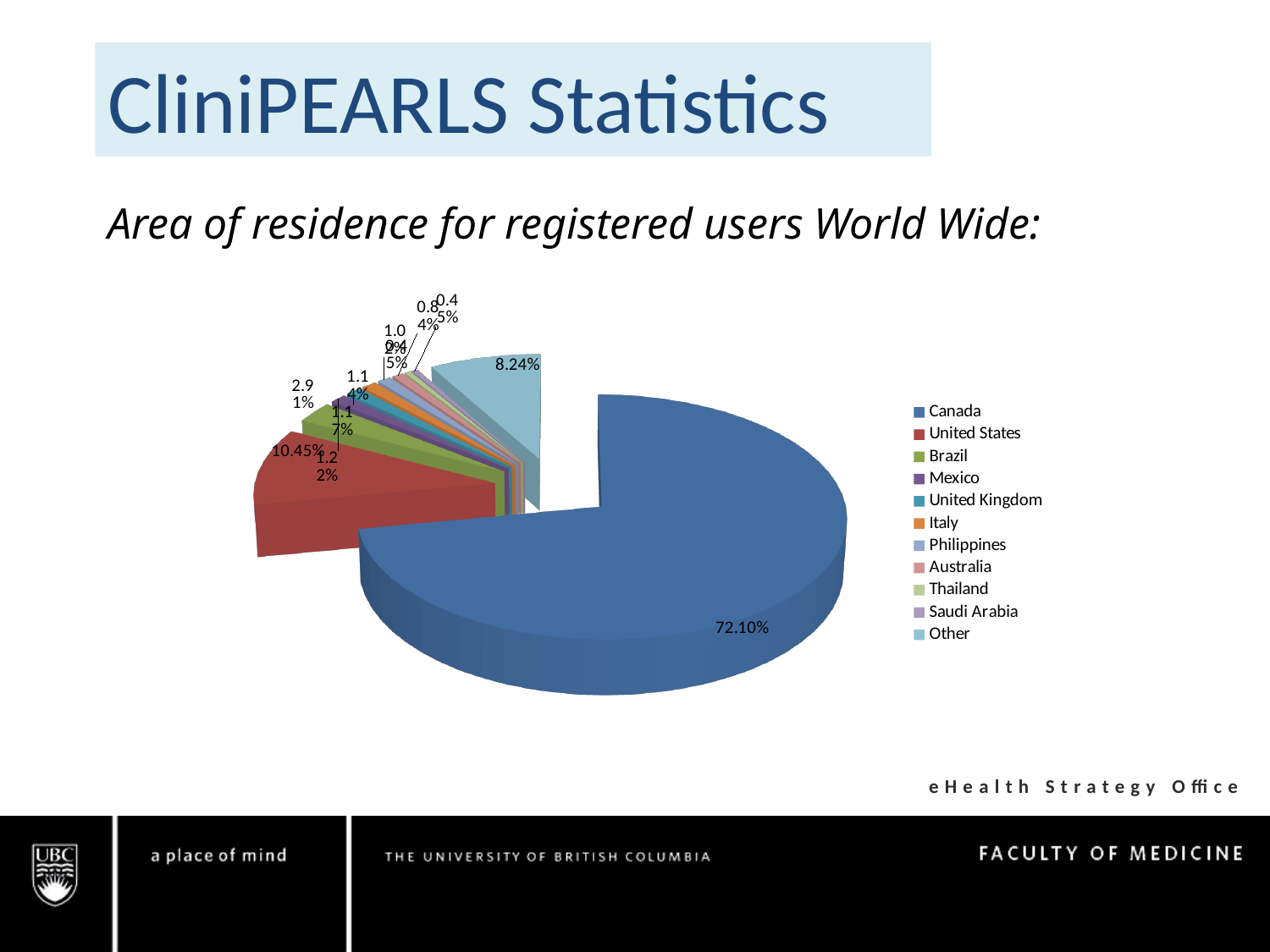
What is the difference in percentage points between the United States share and the 'Other' share? 2.21% What colour is the Canada slice in the pie chart? blue What share of registered users resides in Canada? 72.10% Which has a larger share of registered users, Canada or the United States? Canada Which category is listed first in the pie chart's legend? Canada Which area of residence has the largest share of registered users? Canada What share of registered users falls under the 'Other' category? 8.24% Which has a larger share of registered users, the United States or 'Other'? United States What share of registered users resides in the United States? 10.45% What kind of chart is shown on the slide? pie chart How many categories does the legend of the pie chart list? 11 What is the difference in percentage points between the Canada share and the United States share? 61.65%